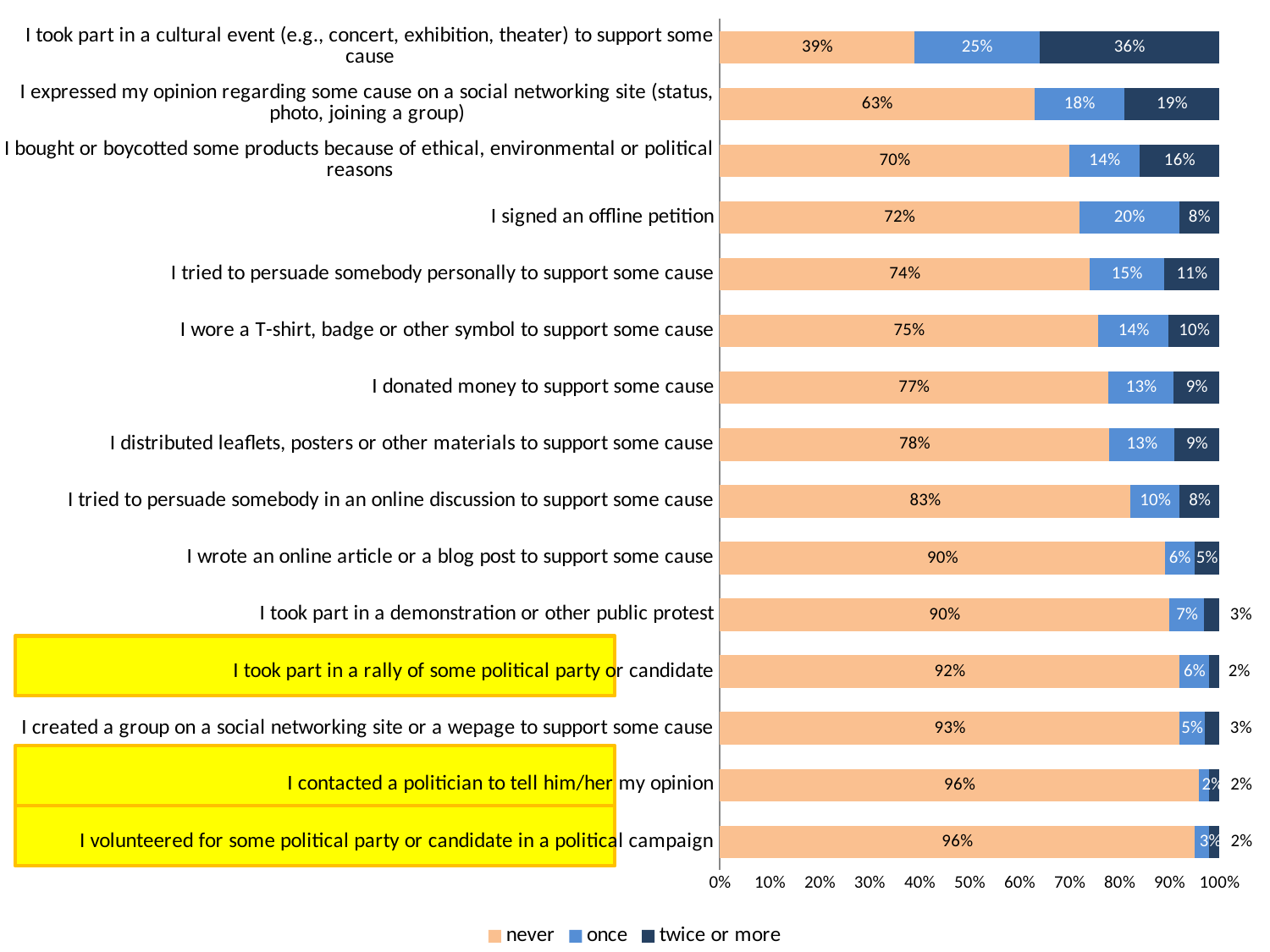
What is the difference in percentage points between the "never" values for "I donated money to support some cause" and "I took part in a cultural event"? 38 percentage points Which activity has the highest "twice or more" percentage? I took part in a cultural event (e.g., concert, exhibition, theater) to support some cause What percentage of respondents answered "never" for "I signed an offline petition"? 72% Which has a larger "once" value: "I signed an offline petition" or "I wore a T-shirt, badge or other symbol to support some cause"? I signed an offline petition How many series does the legend list? 3 What kind of chart is shown on the slide? Stacked bar chart Which series is shown in the dark navy colour in the legend? twice or more What is the total of the stacked bar for "I bought or boycotted some products because of ethical, environmental or political reasons"? 100% How many activities (categories) are shown in the chart? 15 Which activity has the lowest "never" percentage? I took part in a cultural event (e.g., concert, exhibition, theater) to support some cause What is the "twice or more" value for "I took part in a cultural event (e.g., concert, exhibition, theater) to support some cause"? 36% What is the "once" value for "I expressed my opinion regarding some cause on a social networking site (status, photo, joining a group)"? 18%